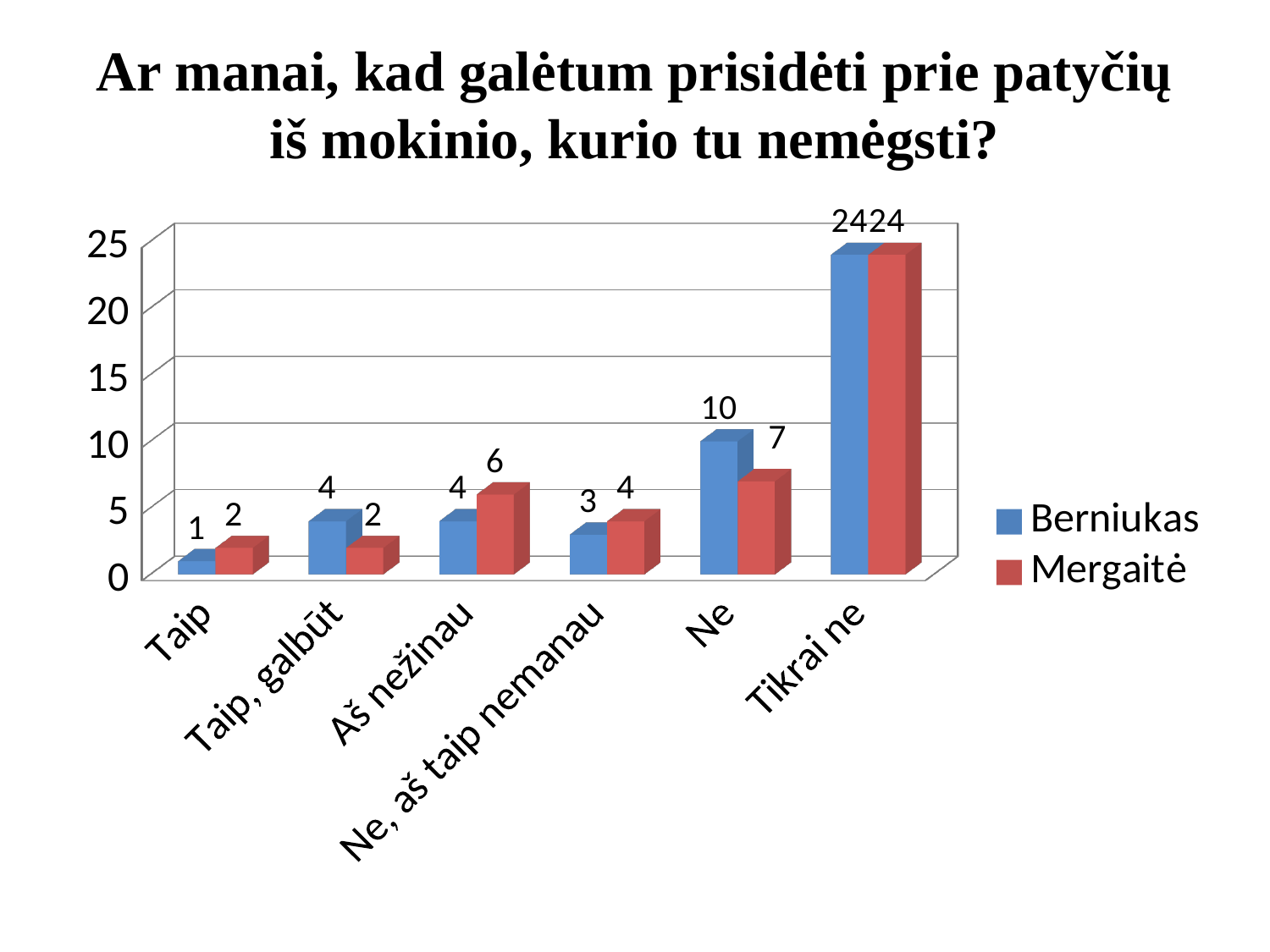
How many series does the legend list? 2 What colour represents the Mergaitė series? Red How many categories are shown on the x axis? 6 Which category has the lowest value for Berniukas? Taip Which category has the highest value for Berniukas? Tikrai ne What is the difference between the Berniukas and Mergaitė values in the 'Ne' category? 3 What kind of chart is shown on the slide? Bar chart What is the value for Berniukas in the 'Taip' category? 1 What is the value for Mergaitė in the 'Tikrai ne' category? 24 What is the value for Mergaitė in the 'Aš nežinau' category? 6 What is the value for Berniukas in the 'Ne' category? 10 In the 'Taip, galbūt' category, which series has the larger value, Berniukas or Mergaitė? Berniukas